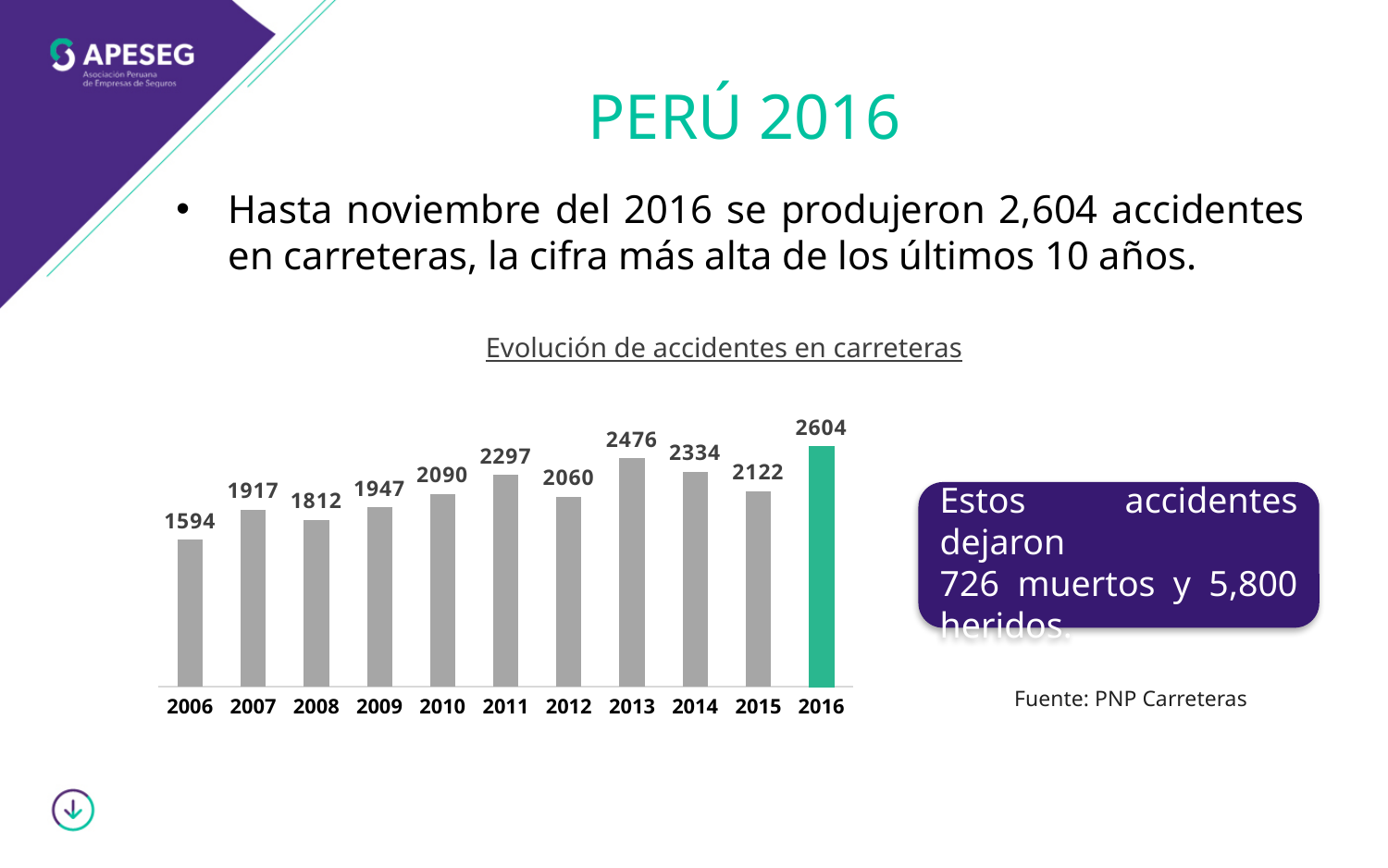
How many years are shown in the chart? 11 What kind of chart is shown on the slide? Bar chart What is the title of the chart? Evolución de accidentes en carreteras Which is larger, the value for 2011 or the value for 2014? 2014 Which year has the highest value in the chart? 2016 What is the difference between the values for 2013 and 2012? 416 What is the value for 2006 in the chart? 1594 Which year has the lowest value in the chart? 2006 What is the value for 2013 in the chart? 2476 What is the value for 2016 in the chart? 2604 Which is larger, the value for 2007 or the value for 2008? 2007 What is the difference between the values for 2016 and 2015? 482